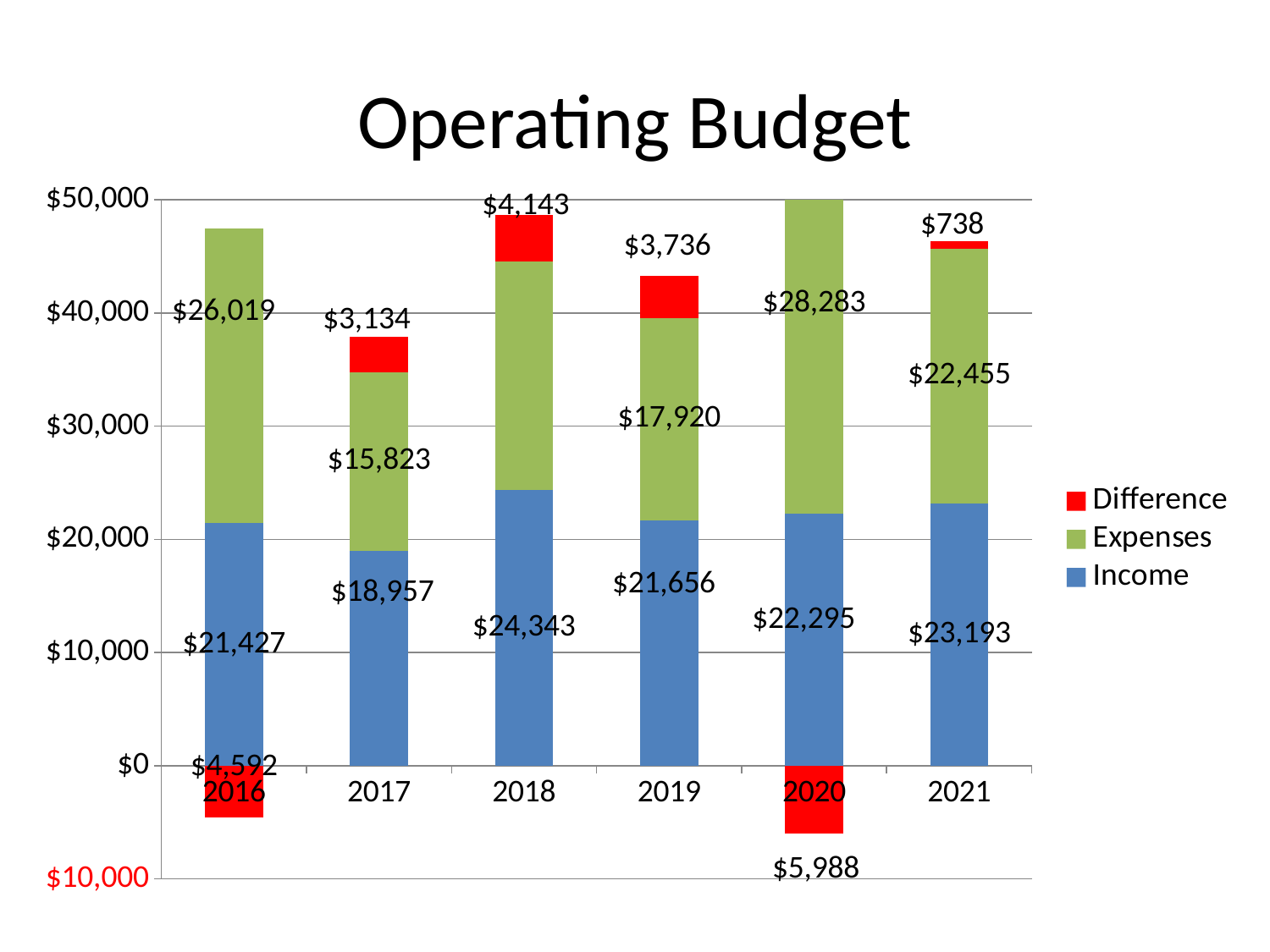
Which year has the lowest Income? 2017 What is the Expenses value for 2020? $28,283 How many series does the legend list? 3 What is the difference between the Income for 2021 and the Income for 2020? $898 What is the Difference value for 2021? $738 Which is larger, the Expenses for 2016 or the Expenses for 2021? 2016 Is the Income value for 2019 greater or less than $20,000? greater How many years are shown on the x axis? 6 What is the Income value for 2018? $24,343 Which year has the highest Income? 2018 What colour represents the Difference series in the legend? Red What kind of chart is shown on the slide? Stacked bar chart